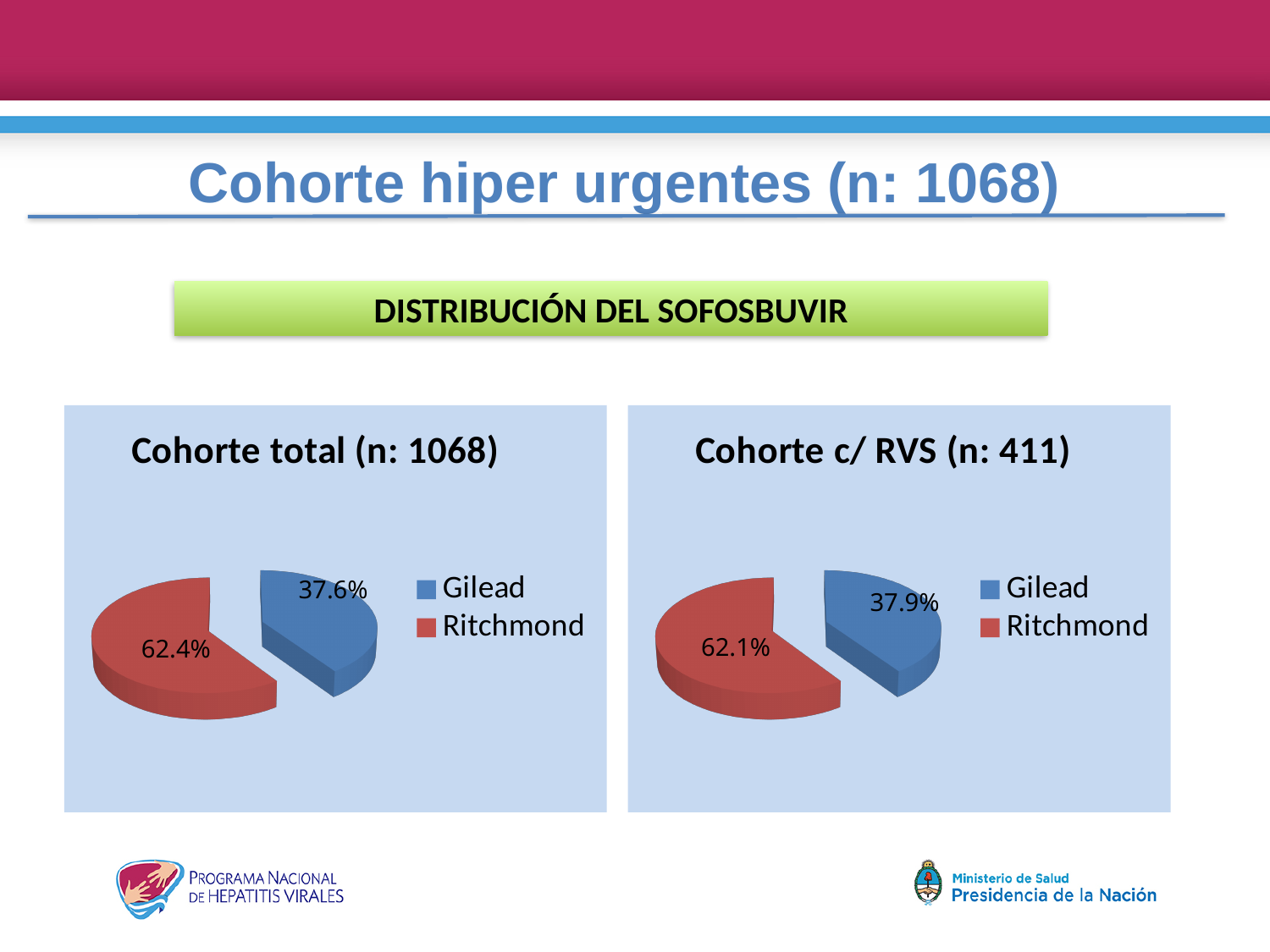
In the 'Cohorte c/ RVS (n: 411)' chart, what percentage is shown for Ritchmond? 62.1% In the 'Cohorte total (n: 1068)' chart, what percentage is shown for Ritchmond? 62.4% In the 'Cohorte c/ RVS (n: 411)' chart, which category has the smallest share? Gilead In the 'Cohorte c/ RVS (n: 411)' chart, what percentage is shown for Gilead? 37.9% In the 'Cohorte total (n: 1068)' chart, what is the difference in percentage points between Ritchmond and Gilead? 24.8 In the 'Cohorte total (n: 1068)' chart, what percentage is shown for Gilead? 37.6% In the 'Cohorte c/ RVS (n: 411)' chart, what is the difference in percentage points between Ritchmond and Gilead? 24.2 How many categories does the legend of the 'Cohorte c/ RVS (n: 411)' chart list? 2 Is the Gilead share in the 'Cohorte c/ RVS (n: 411)' chart larger or smaller than the Gilead share in the 'Cohorte total (n: 1068)' chart? Larger In the 'Cohorte total (n: 1068)' chart, which category has the largest share? Ritchmond In the 'Cohorte total (n: 1068)' chart, which colour represents Gilead? Blue What type of chart is used in the 'Cohorte total (n: 1068)' panel? Pie chart